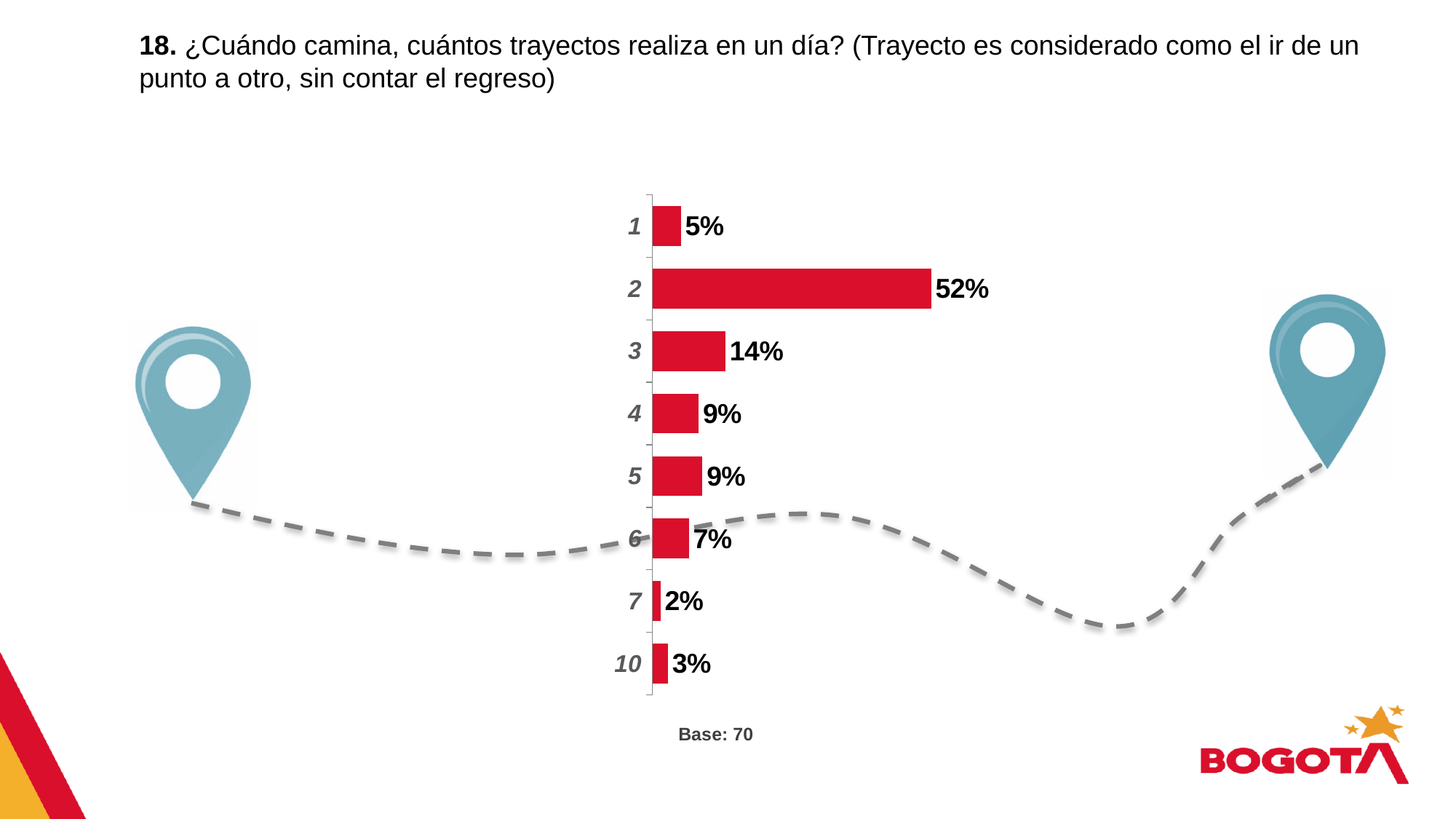
Which is larger, the value for category 6 or the value for category 10? 6 What percentage of respondents make 2 trips per day when walking? 52% What is the value shown for category 10? 3% What is the difference between the values for category 2 and category 3? 38% What base (number of respondents) is stated below the chart? 70 What colour are the bars in the chart? Red How many categories are shown in the chart? 8 What is the value shown for category 3? 14% Which category has the lowest value? 7 Which category has the highest value? 2 What kind of chart is shown on the slide? Bar chart What is the difference between the values for category 1 and category 7? 3%